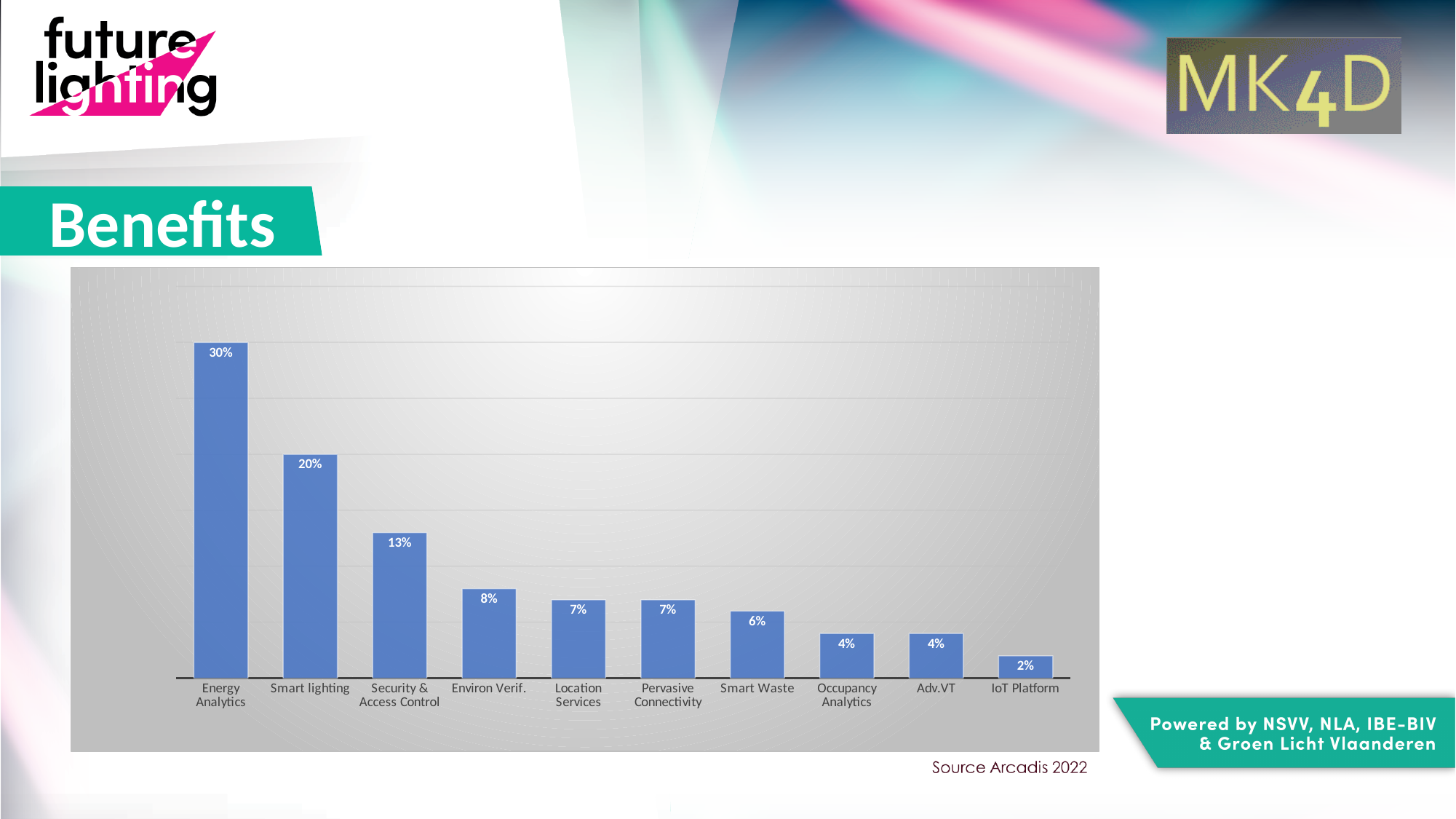
What is the value for Energy Analytics? 30% Which category has the highest value? Energy Analytics What is the value for IoT Platform? 2% How many categories are shown in the chart? 10 What is the value for Security & Access Control? 13% Which is larger, the value for Smart lighting or the value for Security & Access Control? Smart lighting What kind of chart is shown on the slide? Bar chart Which category has the lowest value? IoT Platform What is the difference between the values for Energy Analytics and Smart lighting? 10% What is the value for Smart Waste? 6% What is the difference between the values for Environ Verif. and Occupancy Analytics? 4% Do the values rise or fall from left to right along the x axis? Fall